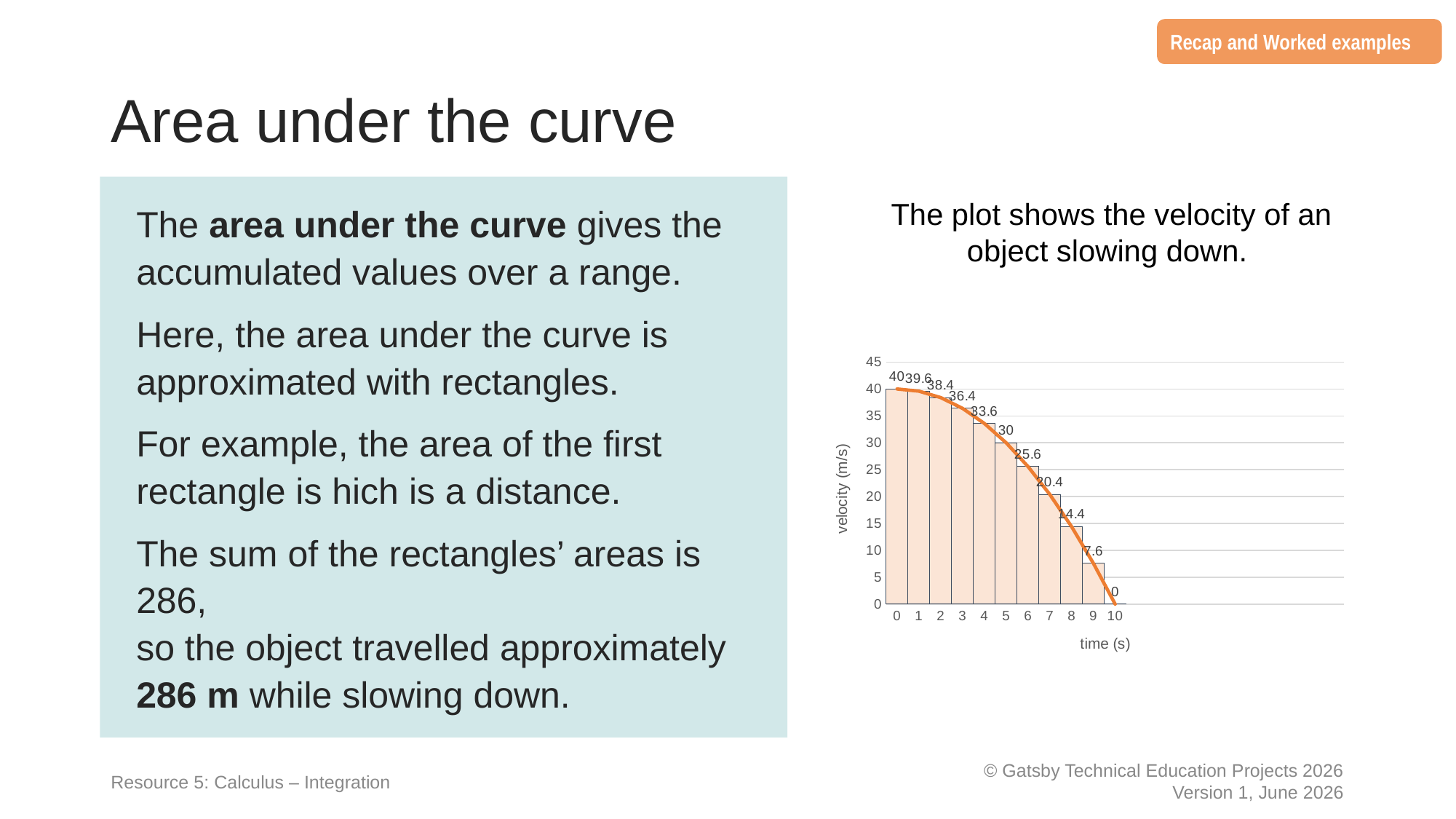
Is the velocity at 6 s greater or less than 30? less At which time is the velocity highest? 0 What is the velocity at time 0 s? 40 What is the velocity at time 5 s? 30 Which is larger, the velocity at 3 s or the velocity at 7 s? 3 s What is the velocity at time 8 s? 14.4 How many time points are labelled on the x axis? 11 At which time is the velocity lowest? 10 What is the label on the y axis? velocity (m/s) Do the velocity values rise or fall as time increases? fall What is the difference between the velocity at 0 s and the velocity at 5 s? 10 What is the velocity at time 9 s? 7.6